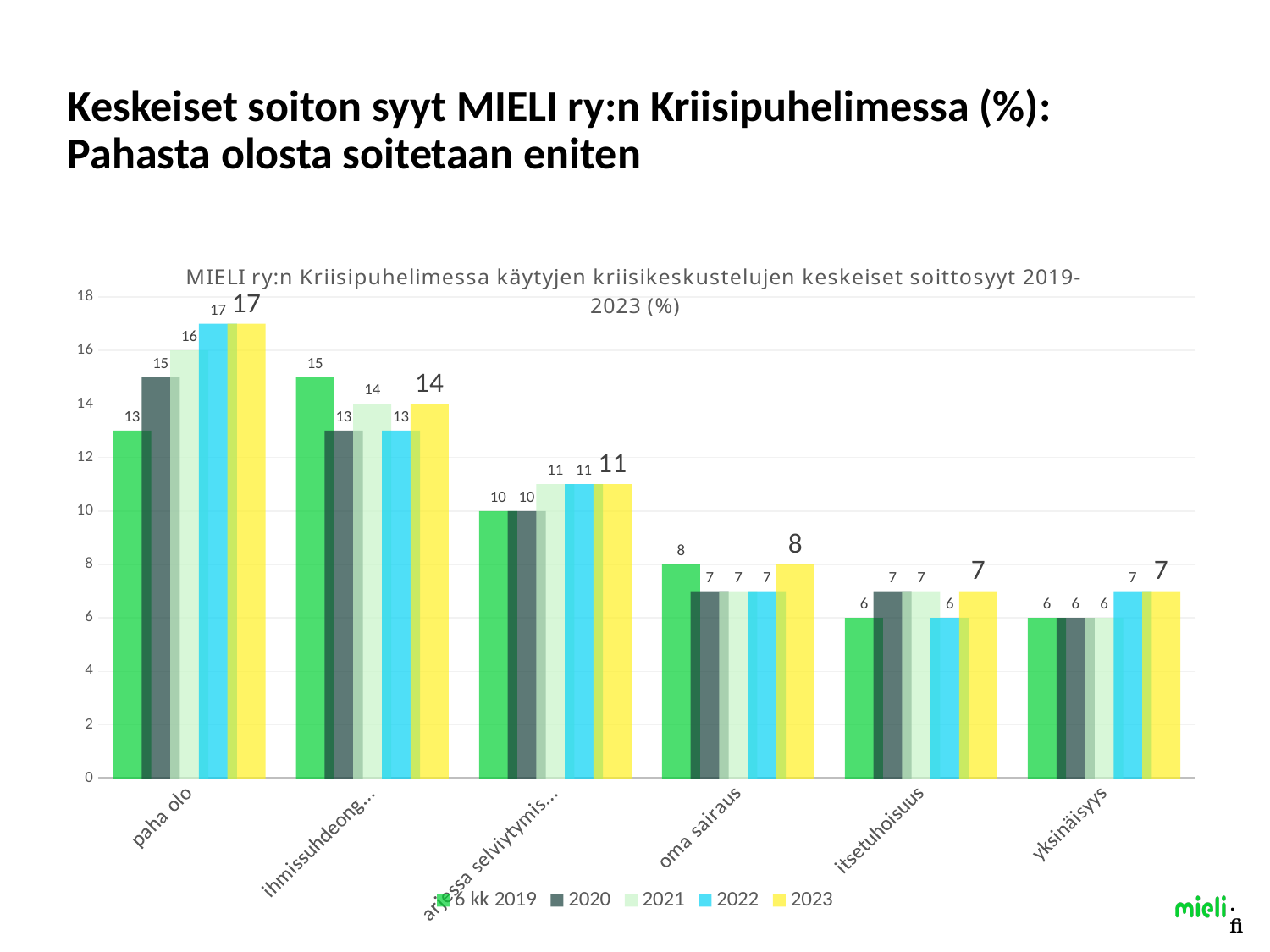
Do the values for paha olo rise or fall from 6 kk 2019 to 2023? rise What is the difference between the 2023 and 6 kk 2019 values for paha olo? 4 What is the value for paha olo in 2023? 17 For itsetuhoisuus, which is larger: the 2020 value or the 2022 value? 2020 What is the value for yksinäisyys in 2022? 7 Which category has the highest value in the 2023 series? paha olo What is the value for oma sairaus in the 6 kk 2019 series? 8 Which category has the lowest value in the 2020 series? yksinäisyys How many categories are shown on the x axis? 6 How many series does the legend list? 5 What is the value for itsetuhoisuus in 2021? 7 What kind of chart is shown on the slide? bar chart